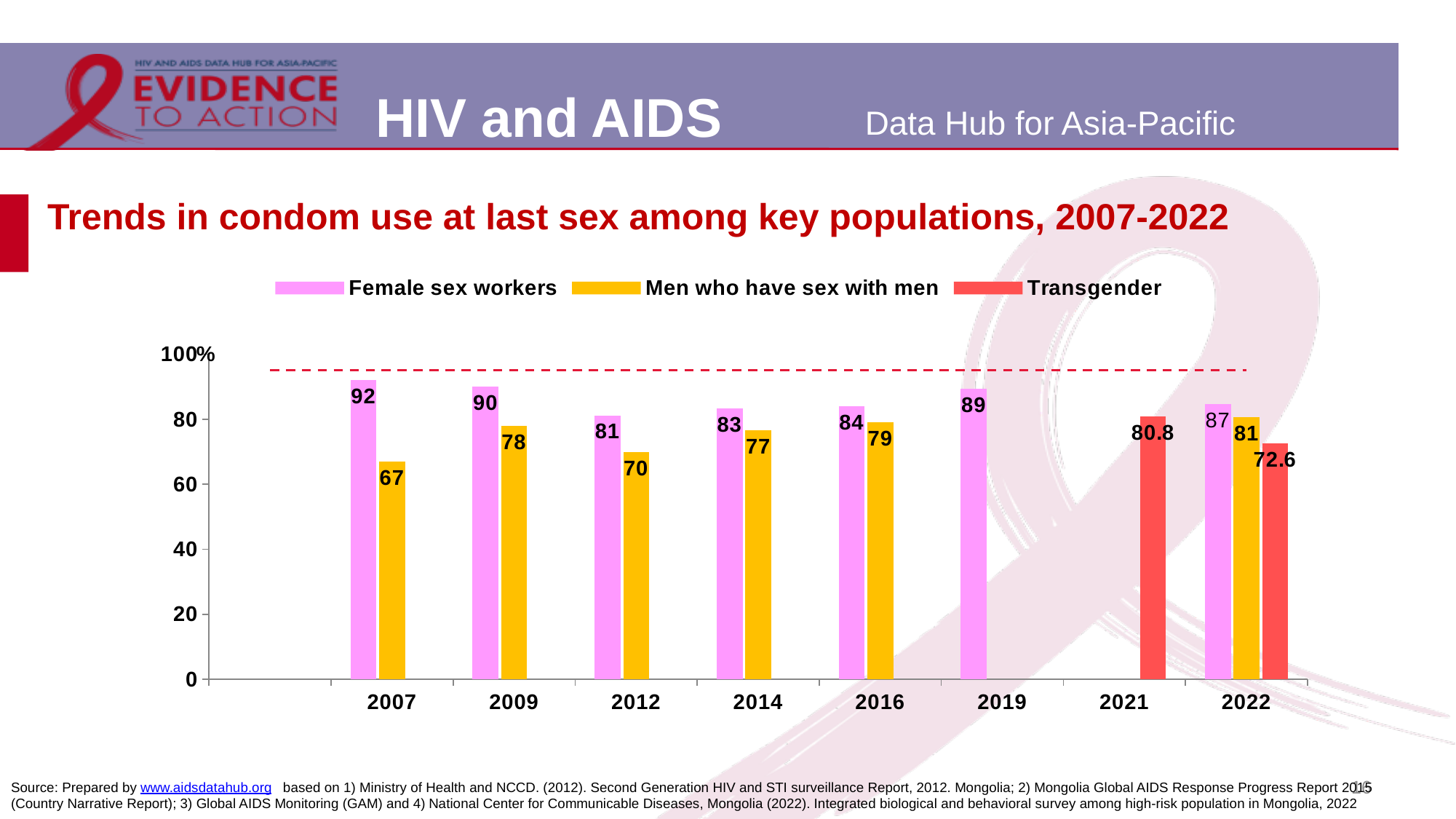
Which is larger in 2022: the value for Men who have sex with men or the value for Transgender? Men who have sex with men Which series is shown in red? Transgender How many series does the legend list? 3 What is the value for Transgender in 2022? 72.6 What kind of chart is shown on the slide? Bar chart In which year is the value for Female sex workers highest? 2007 In which year is the value for Men who have sex with men lowest? 2007 What is the value for Female sex workers in 2007? 92 What is the value for Men who have sex with men in 2012? 70 What is the difference between the Female sex workers and Men who have sex with men values in 2007? 25 What is the value for Transgender in 2021? 80.8 How many years are shown on the x axis? 8